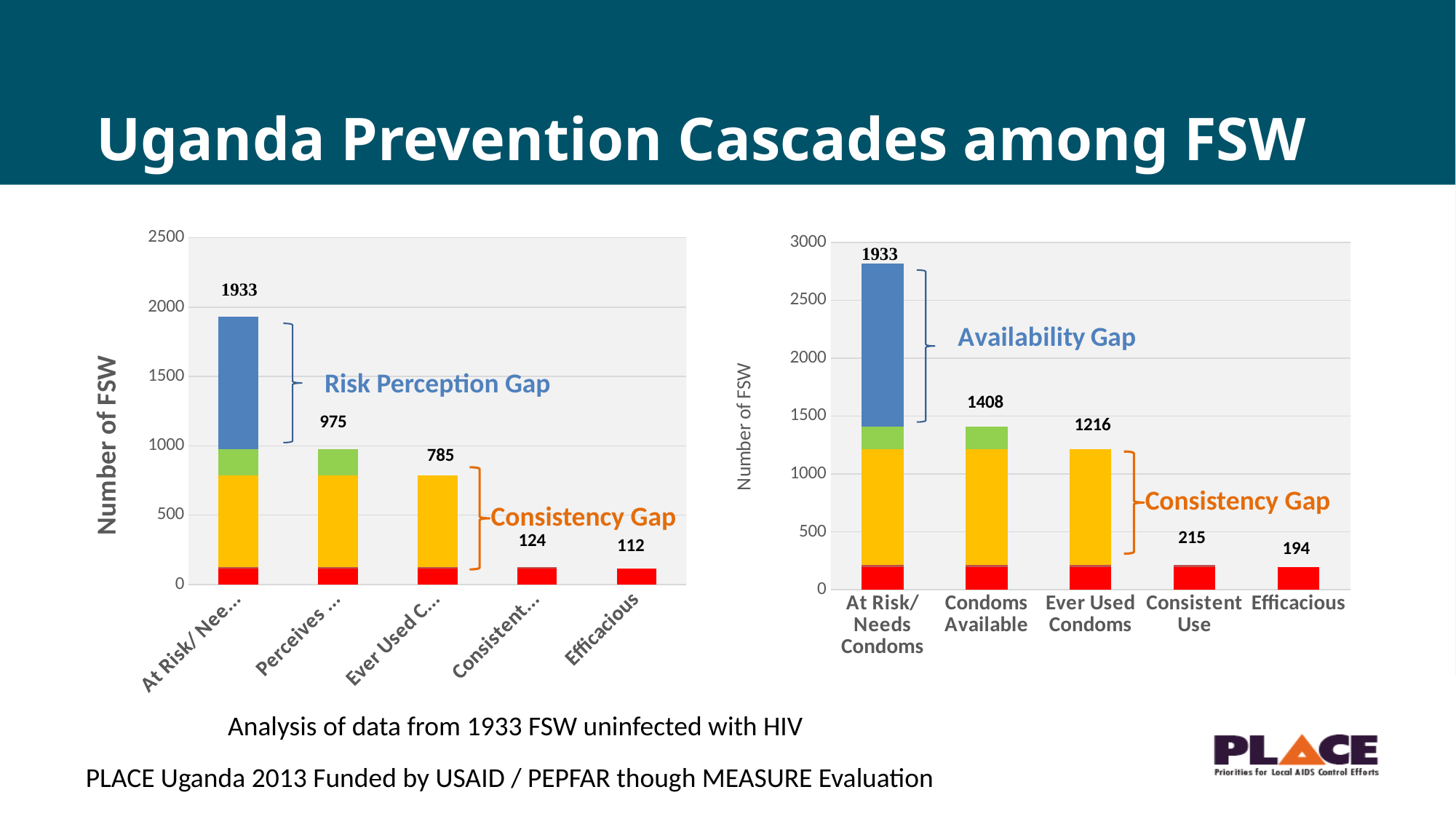
On the left chart, what is the difference between the first bar (1933) and the second bar (975)? 958 On the left chart, what is the value for Efficacious? 112 On the right chart, which category has the highest value? At Risk/ Needs Condoms What kind of chart is the left chart? bar chart On the right chart, what is the value for Condoms Available? 1408 On the right chart, what is the value for Consistent Use? 215 On the right chart, what is the difference between Condoms Available and Ever Used Condoms? 192 How many categories are shown on the right chart? 5 On the left chart, what is the value labelled on the first bar (At Risk/ Needs Condoms)? 1933 On the right chart, what is the value for Ever Used Condoms? 1216 On the right chart, is the value for Consistent Use greater or less than 500? less On the right chart, which category has the lowest value? Efficacious